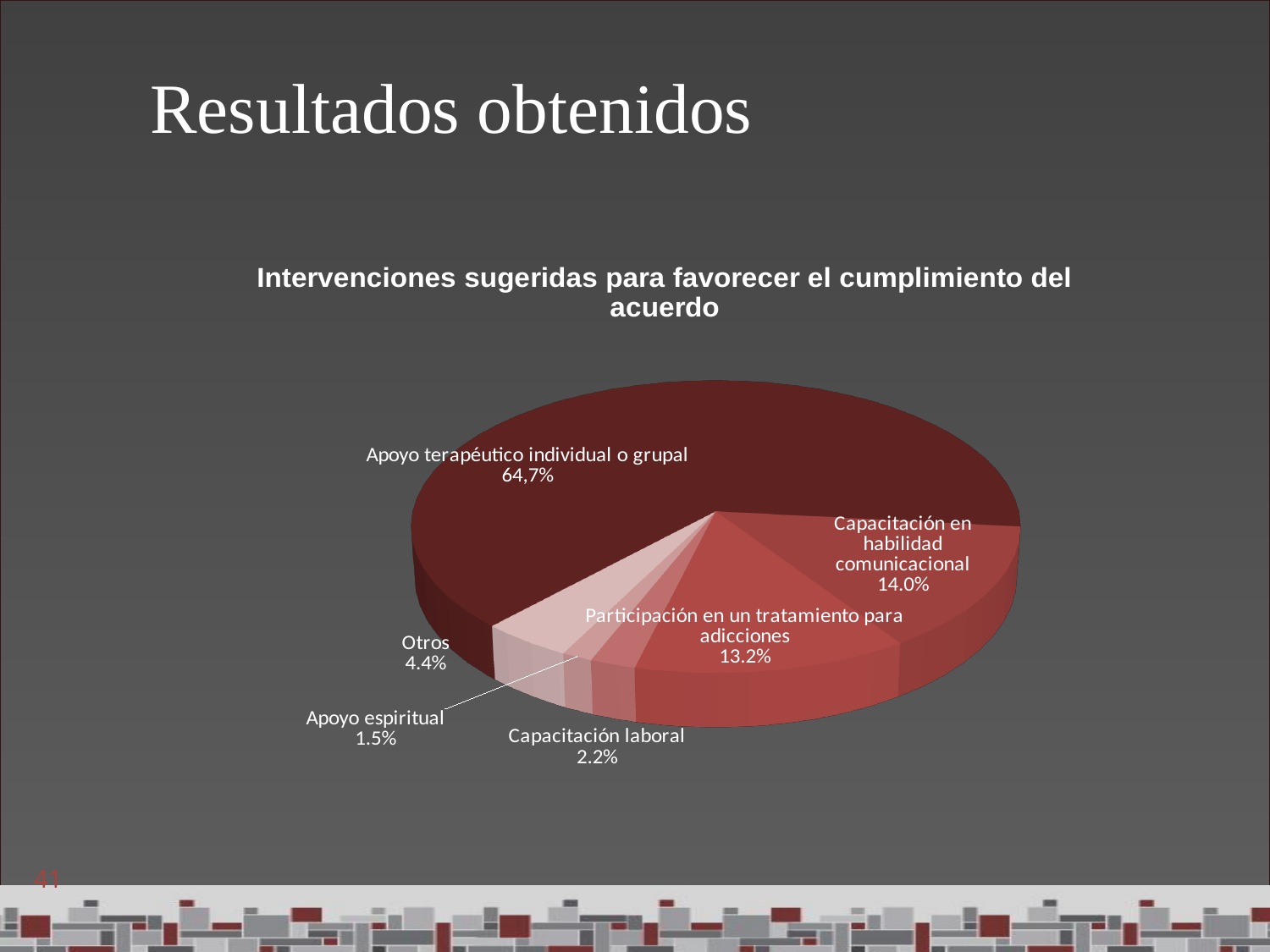
What percentage is shown for Apoyo terapéutico individual o grupal? 64,7% What percentage is shown for Capacitación en habilidad comunicacional? 14.0% What percentage is shown for Participación en un tratamiento para adicciones? 13.2% What percentage is shown for Otros? 4.4% How many slices does the pie chart have? 6 What percentage is shown for Apoyo espiritual? 1.5% What is the title of the chart? Intervenciones sugeridas para favorecer el cumplimiento del acuerdo Which category has the smallest share of the pie? Apoyo espiritual What is the difference in percentage points between Capacitación laboral and Apoyo espiritual? 0.7 What kind of chart is shown on the slide? pie chart Which category has the largest share of the pie? Apoyo terapéutico individual o grupal Which is larger, the share for Otros or the share for Capacitación laboral? Otros